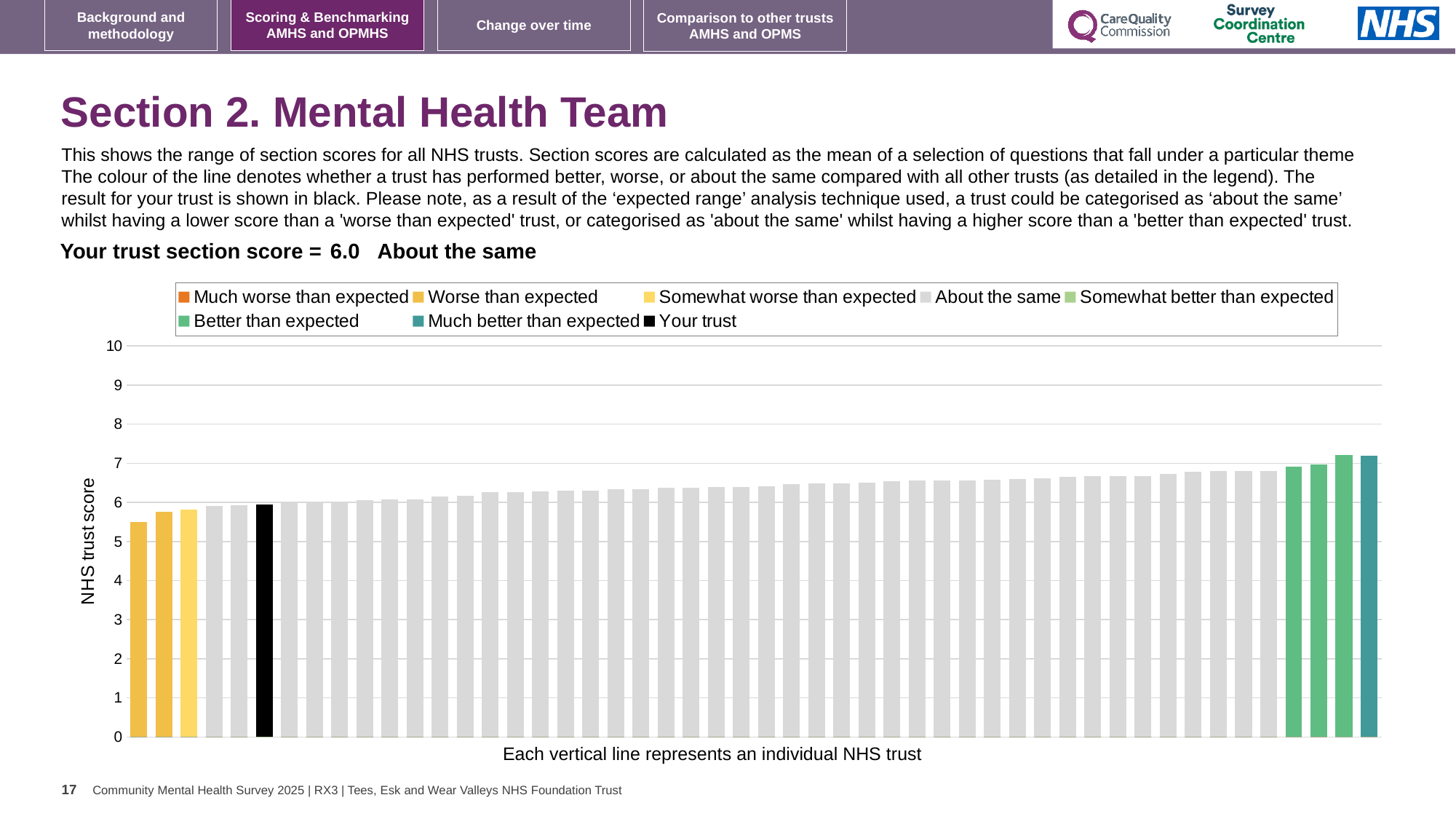
Which performance category is your trust's section score placed in? About the same Is the value of the leftmost (lowest) bar greater or less than 6? less How many bars in the chart are coloured black? 1 Do the bar values rise or fall moving from left to right along the x axis? rise Is the value of the rightmost bar greater or less than 6? greater What is the section score for your trust shown on the slide? 6.0 How many entries does the chart legend list? 8 What is the label on the vertical axis of the chart? NHS trust score What kind of chart is shown on the slide? bar chart Is the value of the black bar (your trust) greater or less than 5? greater What is the highest value shown on the vertical axis? 10 According to the legend, what colour represents 'Your trust'? black